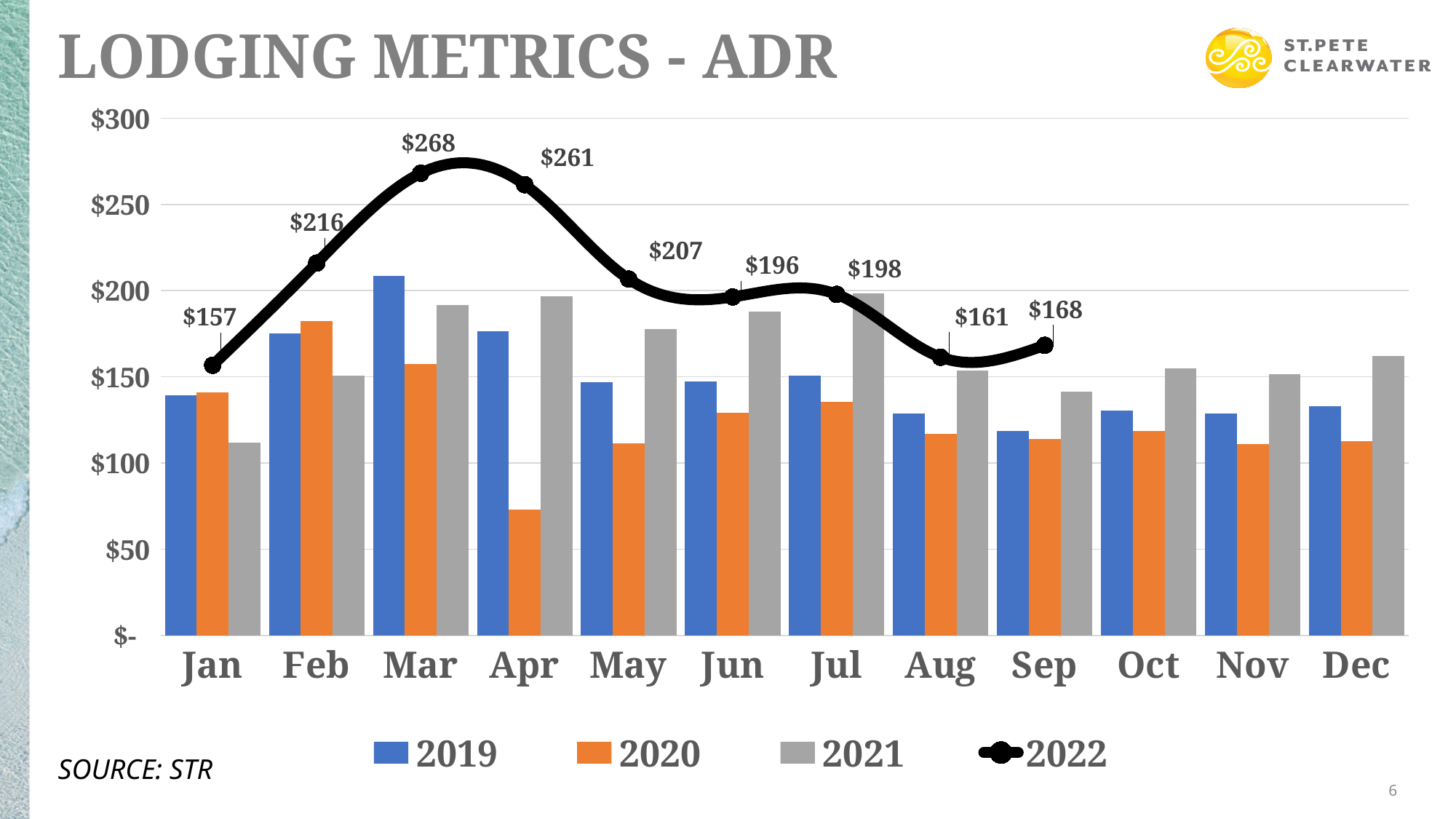
Which month has the highest 2022 value? Mar Is the 2019 value for Mar greater or less than $200? greater What is the difference between the 2022 values for Feb and Jan? $59 Which month has the lowest 2022 value? Jan Do the 2022 values rise or fall from Mar to Jun? fall How many series does the legend list? 4 Is the 2020 value for Apr greater or less than $100? less What is the 2022 ADR value for Jan? $157 How many months are shown on the x axis? 12 Which is larger, the 2022 value for Jun or for Jul? Jul What is the 2022 ADR value for Mar? $268 What is the difference between the 2022 values for Mar and Apr? $7